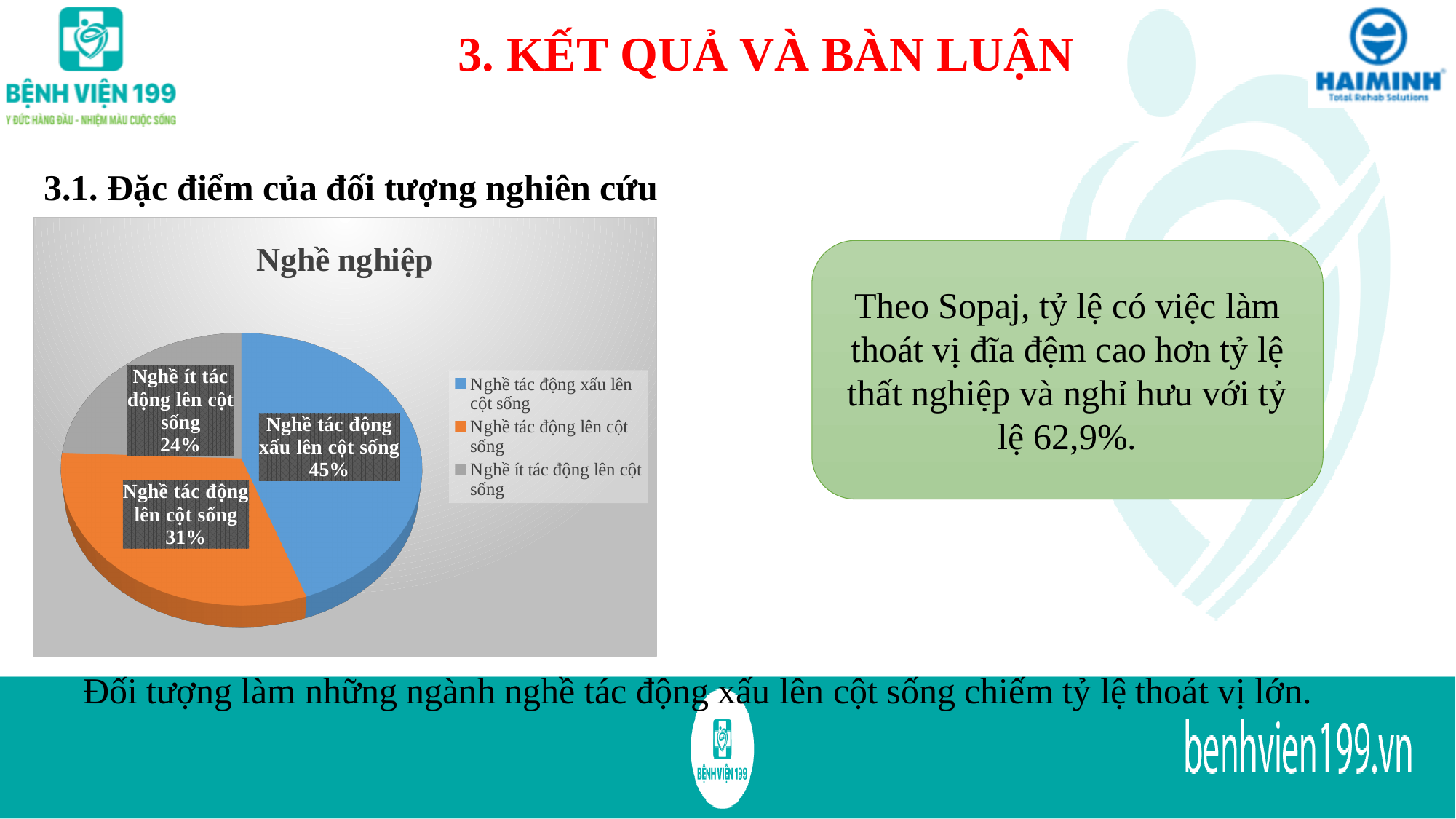
What share of the pie does "Nghề ít tác động lên cột sống" have? 24% How many categories does the pie chart show? 3 What share of the pie does "Nghề tác động lên cột sống" have? 31% What is the title of the pie chart? Nghề nghiệp What is the difference in percentage points between "Nghề tác động xấu lên cột sống" and "Nghề tác động lên cột sống"? 14% Which category has the largest share of the pie? Nghề tác động xấu lên cột sống What is the difference in percentage points between "Nghề tác động xấu lên cột sống" and "Nghề ít tác động lên cột sống"? 21% What share of the pie does "Nghề tác động xấu lên cột sống" have? 45% What kind of chart is shown on the slide? Pie chart What colour is the slice for "Nghề tác động lên cột sống"? Orange Which is larger: the share for "Nghề tác động lên cột sống" or the share for "Nghề ít tác động lên cột sống"? Nghề tác động lên cột sống Which category has the smallest share of the pie? Nghề ít tác động lên cột sống